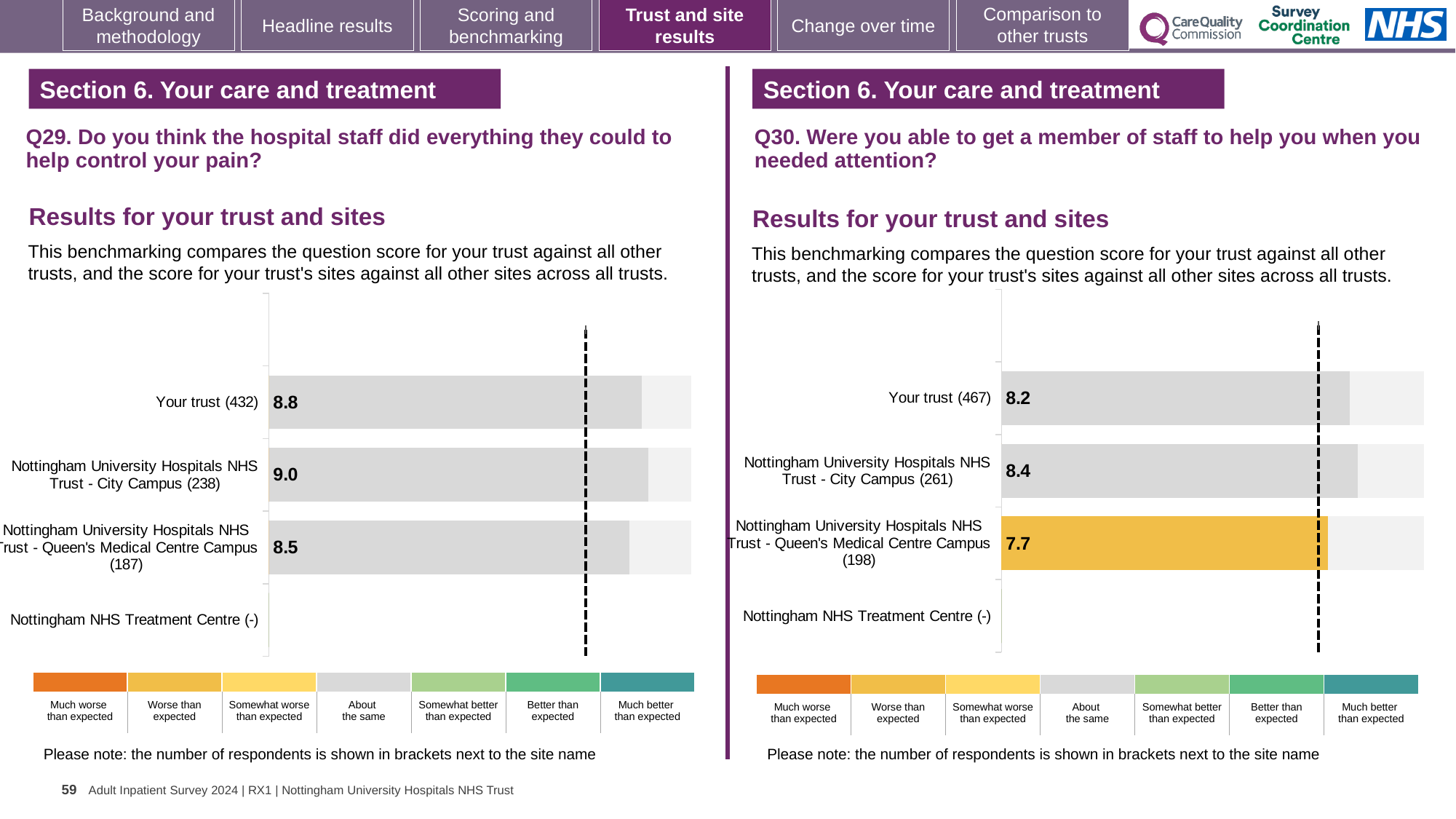
On the Q30 chart (right), what is the score for Your trust (467)? 8.2 On the Q30 chart (right), what is the difference between the City Campus score and the Queen's Medical Centre Campus score? 0.7 On the Q30 chart (right), which is larger: the score for Your trust or the score for City Campus? City Campus On the Q30 chart (right), which site has the lowest score? Nottingham University Hospitals NHS Trust - Queen's Medical Centre Campus (198) On the Q29 chart (left), what is the difference between the City Campus score and the Queen's Medical Centre Campus score? 0.5 On the Q29 chart (left), what is the score for Nottingham University Hospitals NHS Trust - Queen's Medical Centre Campus (187)? 8.5 On the Q30 chart (right), which site's bar is coloured yellow rather than grey? Nottingham University Hospitals NHS Trust - Queen's Medical Centre Campus (198) On the Q30 chart (right), what is the score for Nottingham University Hospitals NHS Trust - Queen's Medical Centre Campus (198)? 7.7 What kind of chart is used on the Q29 chart (left)? Bar chart On the Q29 chart (left), what is the score for Nottingham University Hospitals NHS Trust - City Campus (238)? 9.0 On the Q29 chart (left), what is the score for Your trust (432)? 8.8 On the Q29 chart (left), which site has the highest score? Nottingham University Hospitals NHS Trust - City Campus (238)